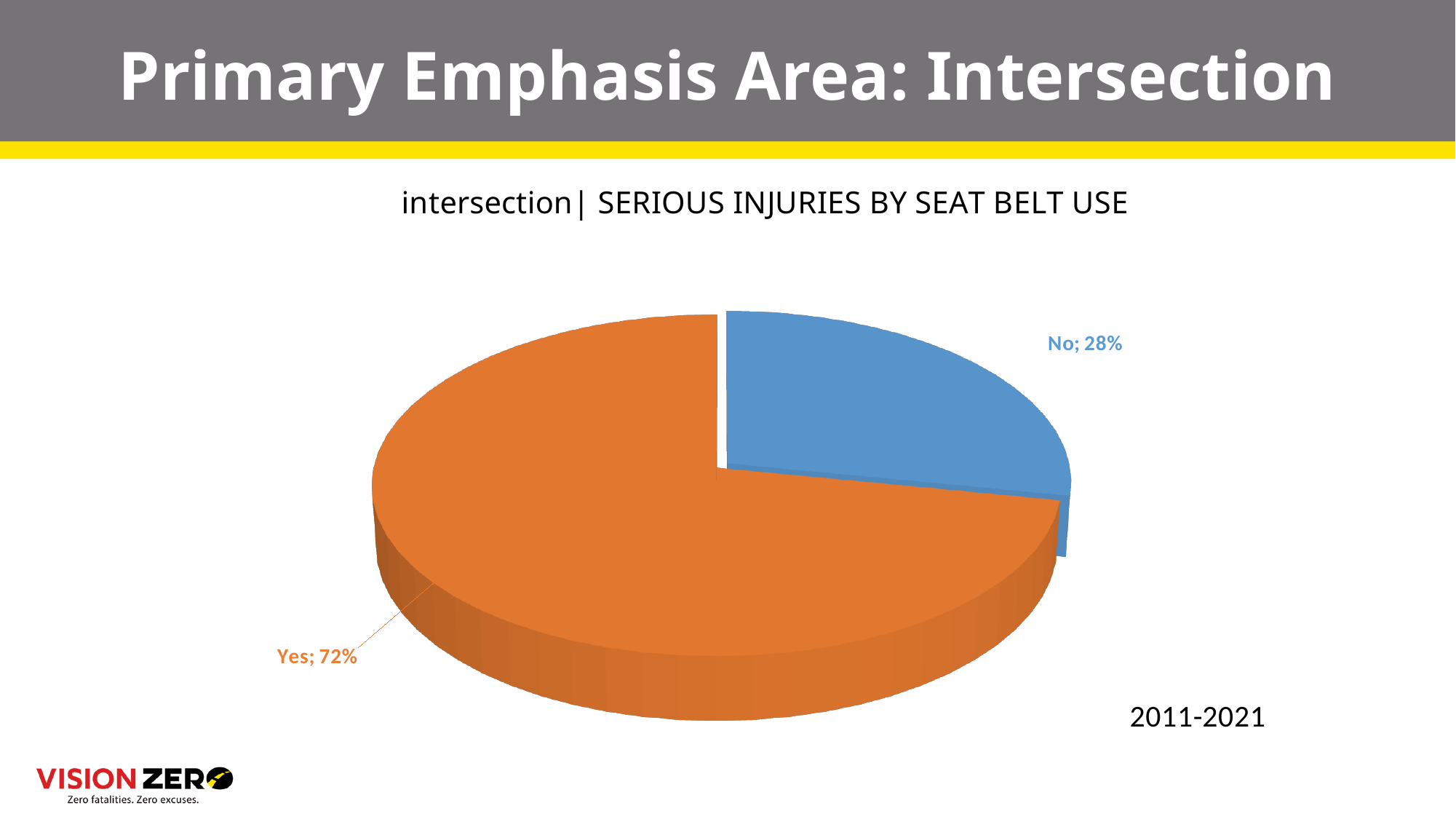
What is the difference in percentage points between the Yes and No slices? 44 Which category has the smallest slice of the pie? No What kind of chart is shown on the slide? pie chart What colour is the No slice? blue Which category has the largest slice of the pie? Yes What share of serious injuries at intersections did not involve seat belt use (No)? 28% What time period does the chart cover? 2011-2021 Which slice is larger, Yes or No? Yes How many slices does the pie chart have? 2 What is the title of the chart? intersection| SERIOUS INJURIES BY SEAT BELT USE What share of serious injuries at intersections involved seat belt use (Yes)? 72%